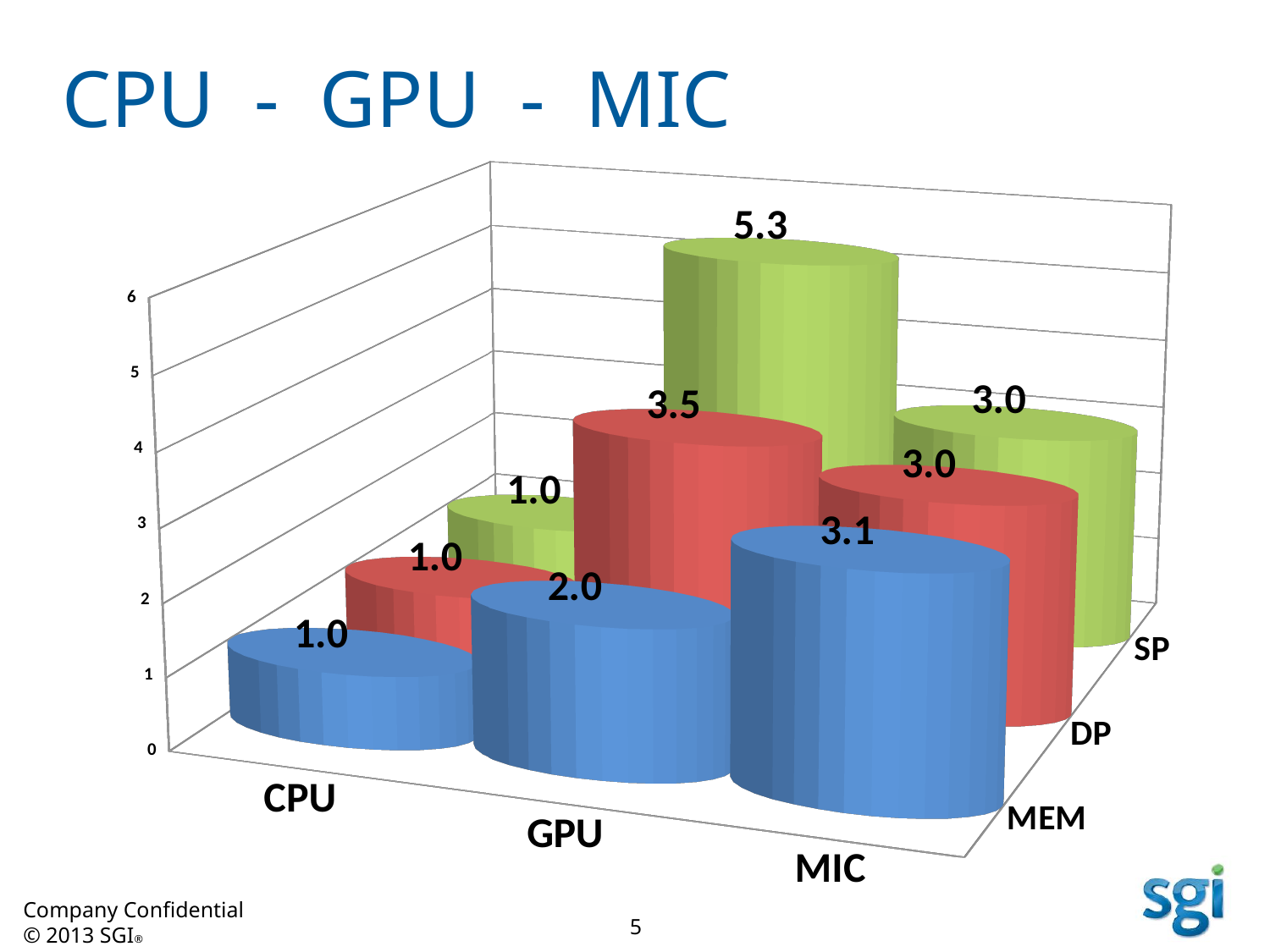
What is the MEM value for MIC? 3.1 What is the DP value for GPU? 3.5 Is the SP value for GPU greater or less than 5? greater What is the difference between the SP value for GPU and the SP value for MIC? 2.3 How many categories are shown along the front axis of the chart? 3 What type of chart is shown on the slide? 3D bar chart What is the MEM value for CPU? 1.0 What is the SP value for GPU? 5.3 How many series (MEM, DP, SP) does the chart show? 3 Which is larger: the DP value for GPU or the DP value for MIC? GPU Which category has the highest SP value? GPU Which category has the lowest MEM value? CPU